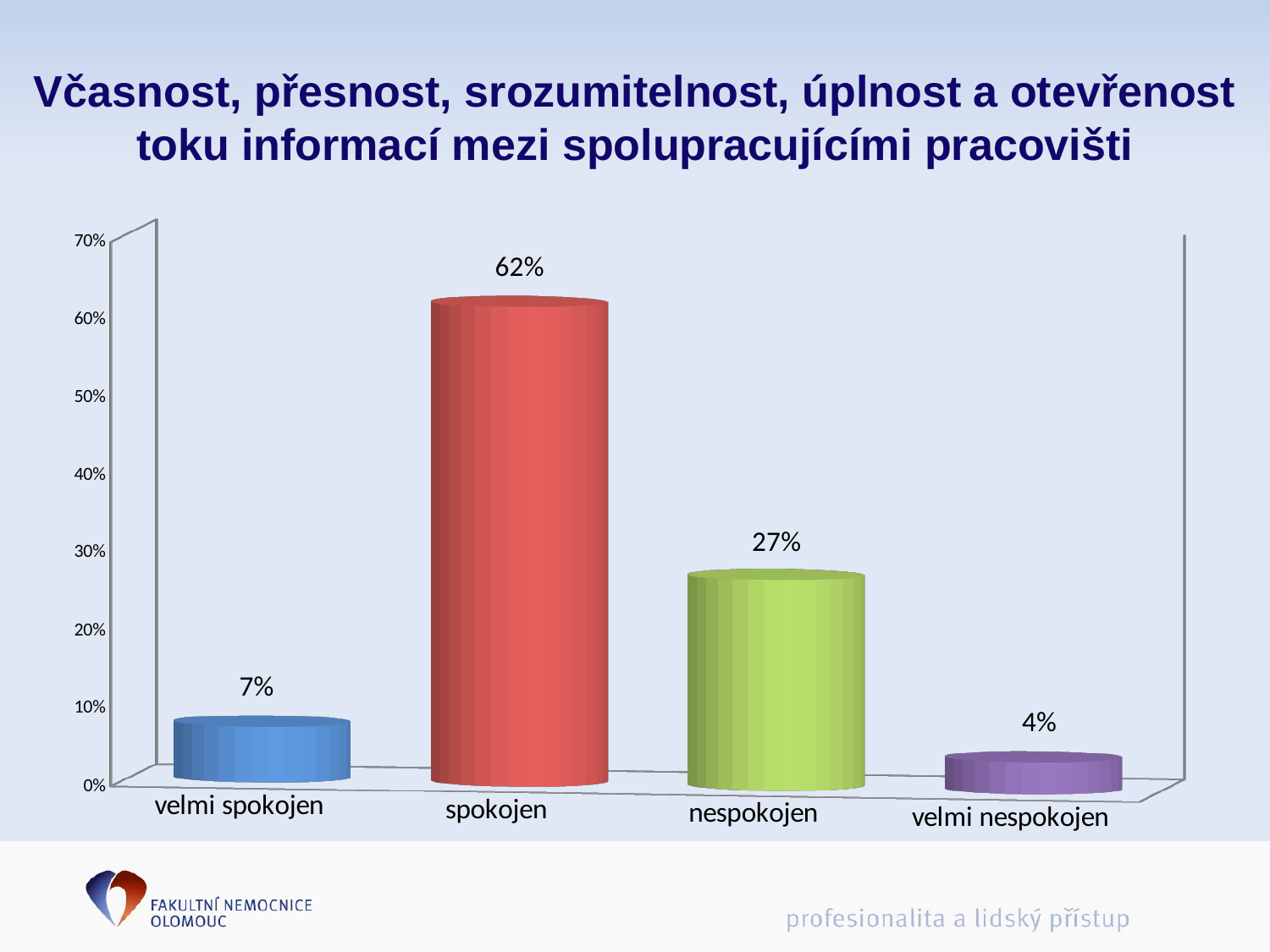
What is the value for "nespokojen"? 27% What kind of chart is shown on the slide? bar chart What is the difference between the values for "spokojen" and "nespokojen"? 35% What colour is the bar for "spokojen"? red What is the value for "velmi nespokojen"? 4% What is the value for "velmi spokojen"? 7% How many categories are shown on the x axis? 4 Which category has the lowest value? velmi nespokojen Is the value for "nespokojen" greater or less than 30%? less Which category has the highest value? spokojen What is the value for "spokojen"? 62% Which is larger, the value for "velmi spokojen" or the value for "velmi nespokojen"? velmi spokojen